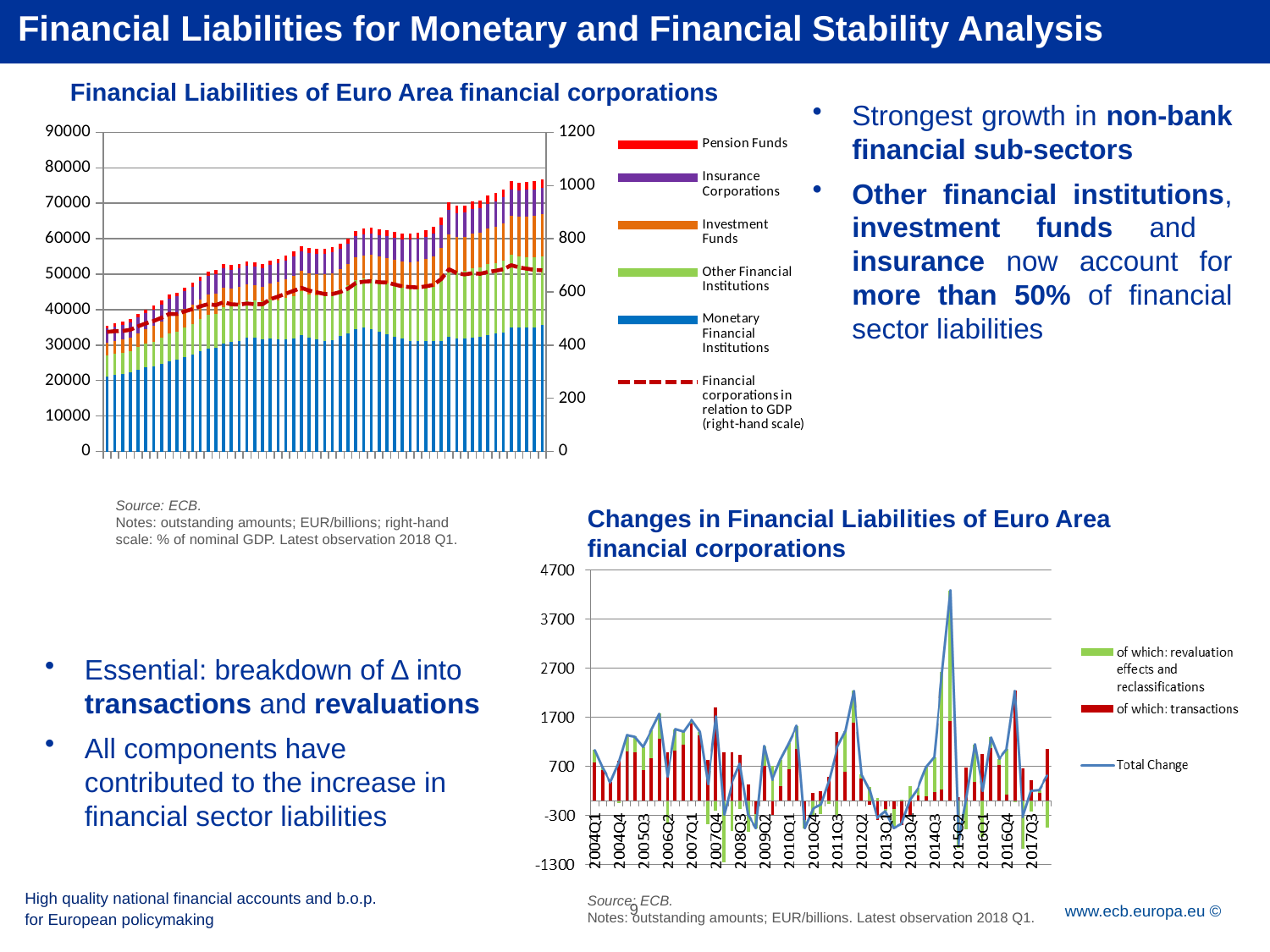
In the 'Financial Liabilities of Euro Area financial corporations' chart, do the total stacked bar values generally rise or fall from left to right? Rise In the 'Financial Liabilities of Euro Area financial corporations' chart, is the total of the first stacked bar greater or less than 40000? less In the 'Financial Liabilities of Euro Area financial corporations' chart, what is the maximum value shown on the right-hand axis? 1200 How many entries does the legend of the 'Financial Liabilities of Euro Area financial corporations' chart list? 6 In the 'Changes in Financial Liabilities of Euro Area financial corporations' chart, is the highest value of the Total Change line greater or less than 3700? greater What kind of chart is the 'Changes in Financial Liabilities of Euro Area financial corporations' chart? Stacked bar chart with a line In the 'Changes in Financial Liabilities of Euro Area financial corporations' chart, what is the lowest value shown on the vertical axis? -1300 What kind of chart is the 'Financial Liabilities of Euro Area financial corporations' chart? Stacked bar chart with a line In the 'Financial Liabilities of Euro Area financial corporations' chart, which series forms the bottom (blue) segment of the stacked bars? Monetary Financial Institutions How many entries does the legend of the 'Changes in Financial Liabilities of Euro Area financial corporations' chart list? 3 In the 'Financial Liabilities of Euro Area financial corporations' chart, is the total of the last stacked bar greater or less than 70000? greater